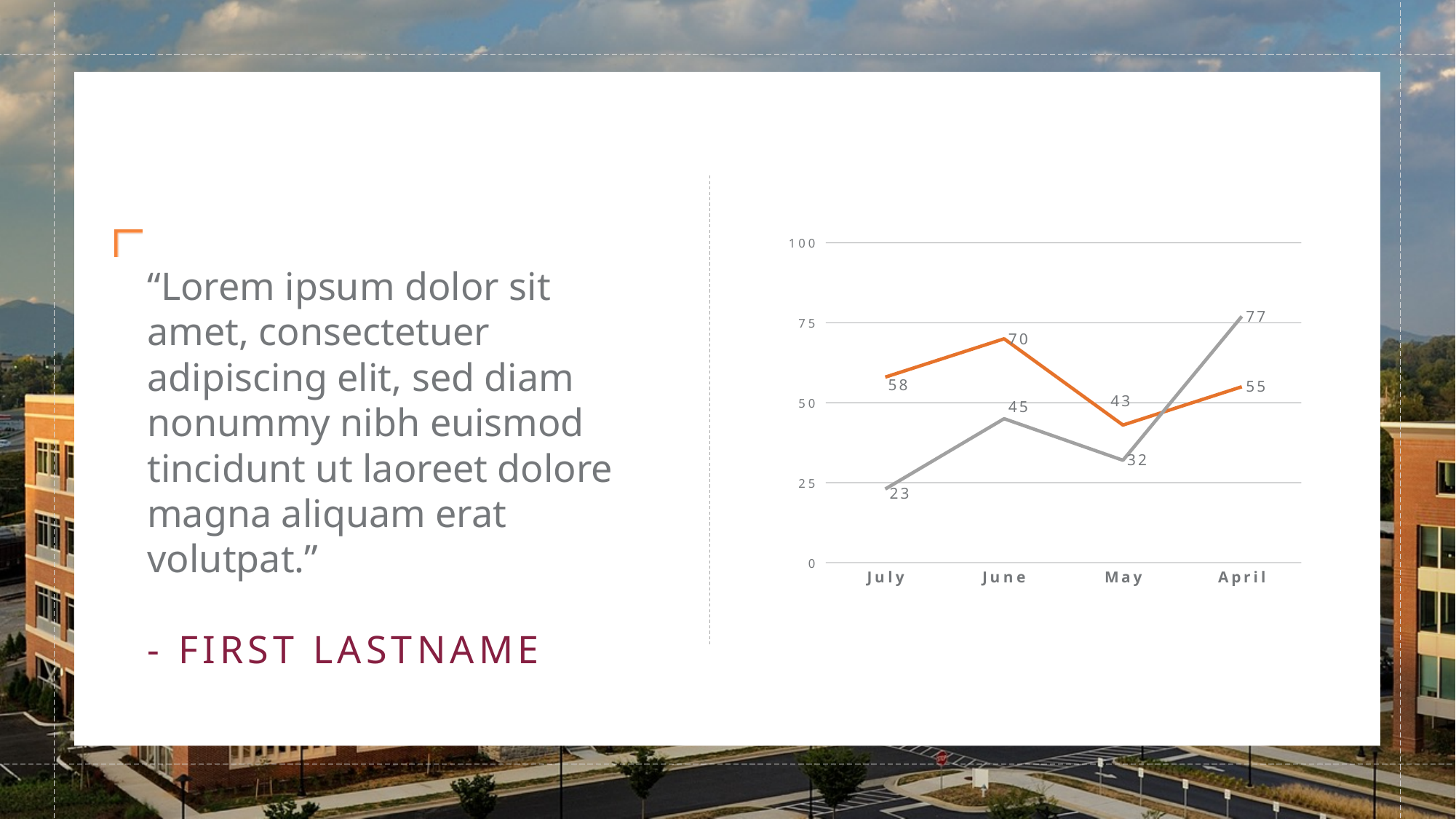
How many categories are shown on the x axis of the chart? 4 What type of chart is shown on the slide? line chart For which month does the gray line have its lowest value? July For which month does the orange line reach its highest value? June What is the difference between the orange line's value for June and its value for May? 27 What is the value of the orange line for June? 70 What is the difference between the gray line's value for April and the orange line's value for April? 22 Is the gray line's value for May greater or less than 50? less What is the value of the gray line for April? 77 What is the value of the orange line for May? 43 What is the value of the gray line for July? 23 Which line has the larger value for April, the orange line or the gray line? the gray line